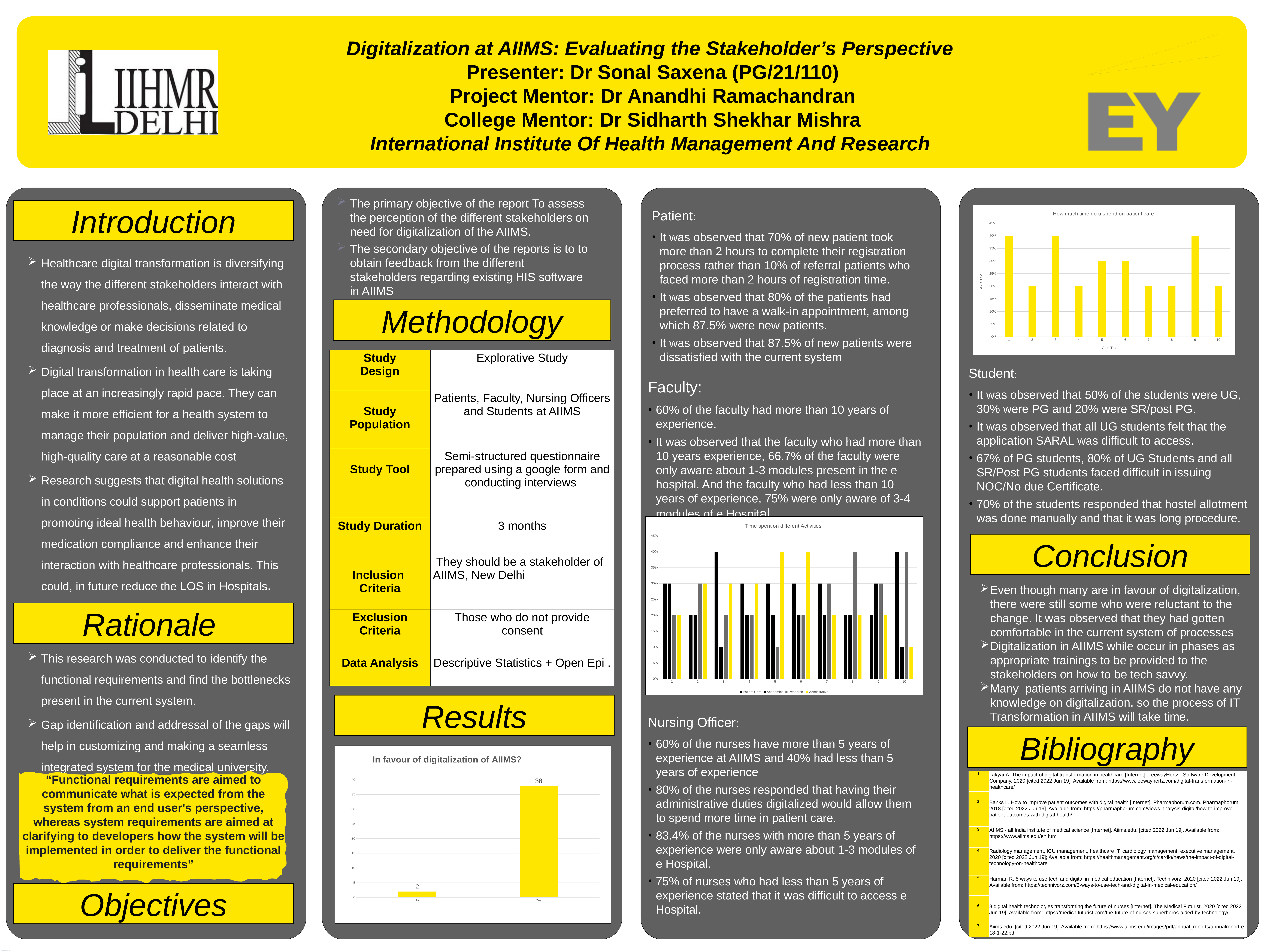
In the 'In favour of digitalization of AIIMS?' chart, which category has the higher value? Yes How many categories are shown along the x axis of the 'Time spent on different Activities' chart? 10 In the 'In favour of digitalization of AIIMS?' chart, what is the difference between the Yes and No values? 36 In the 'In favour of digitalization of AIIMS?' chart, what is the value for No? 2 How many series does the legend of the 'Time spent on different Activities' chart list? 4 How many bars are shown in the 'How much time do u spend on patient care' chart? 10 In the 'How much time do u spend on patient care' chart, is the value for category 2 greater or less than 30%? less In the 'In favour of digitalization of AIIMS?' chart, what is the value for Yes? 38 How many categories are shown in the 'In favour of digitalization of AIIMS?' chart? 2 What kind of chart is the 'In favour of digitalization of AIIMS?' chart? Bar chart What are the series names in the legend of the 'Time spent on different Activities' chart? Patient Care, Academics, Research, Admisitrative In the 'How much time do u spend on patient care' chart, is the value for category 1 greater or less than 30%? greater